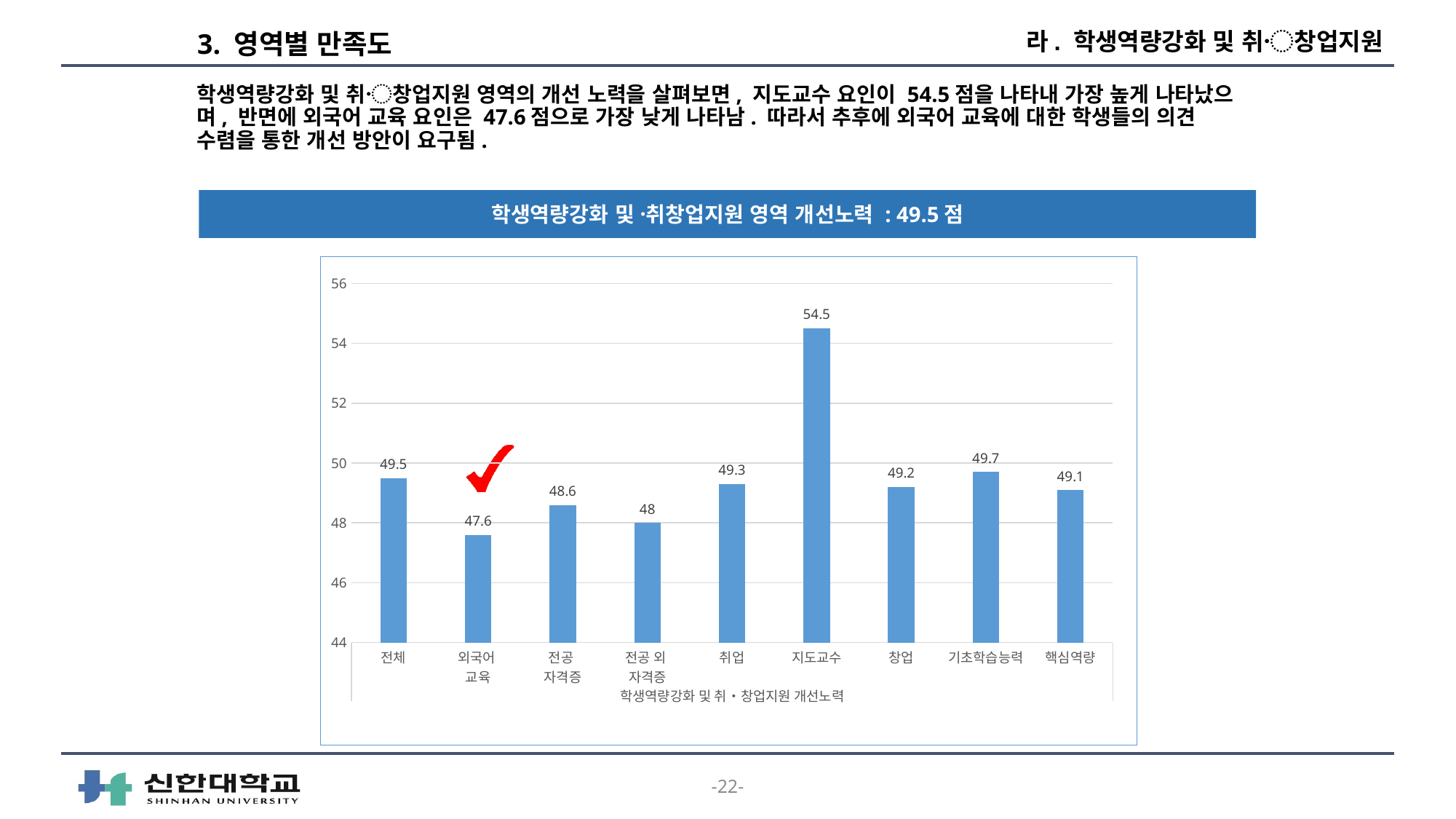
What is the value for 지도교수? 54.5 What is the value for 전공 외 자격증? 48 What is the value for 외국어 교육? 47.6 Is the value for 취업 greater or less than 50? less How many categories are plotted in the chart? 9 What is the difference between the values for 지도교수 and 외국어 교육? 6.9 Which category has the lowest value? 외국어 교육 What kind of chart is shown on the slide? bar chart What is the value for 기초학습능력? 49.7 Which is larger, the value for 전공 자격증 or the value for 전공 외 자격증? 전공 자격증 What is the x-axis title of the chart? 학생역량강화 및 취·창업지원 개선노력 Which category has the highest value? 지도교수